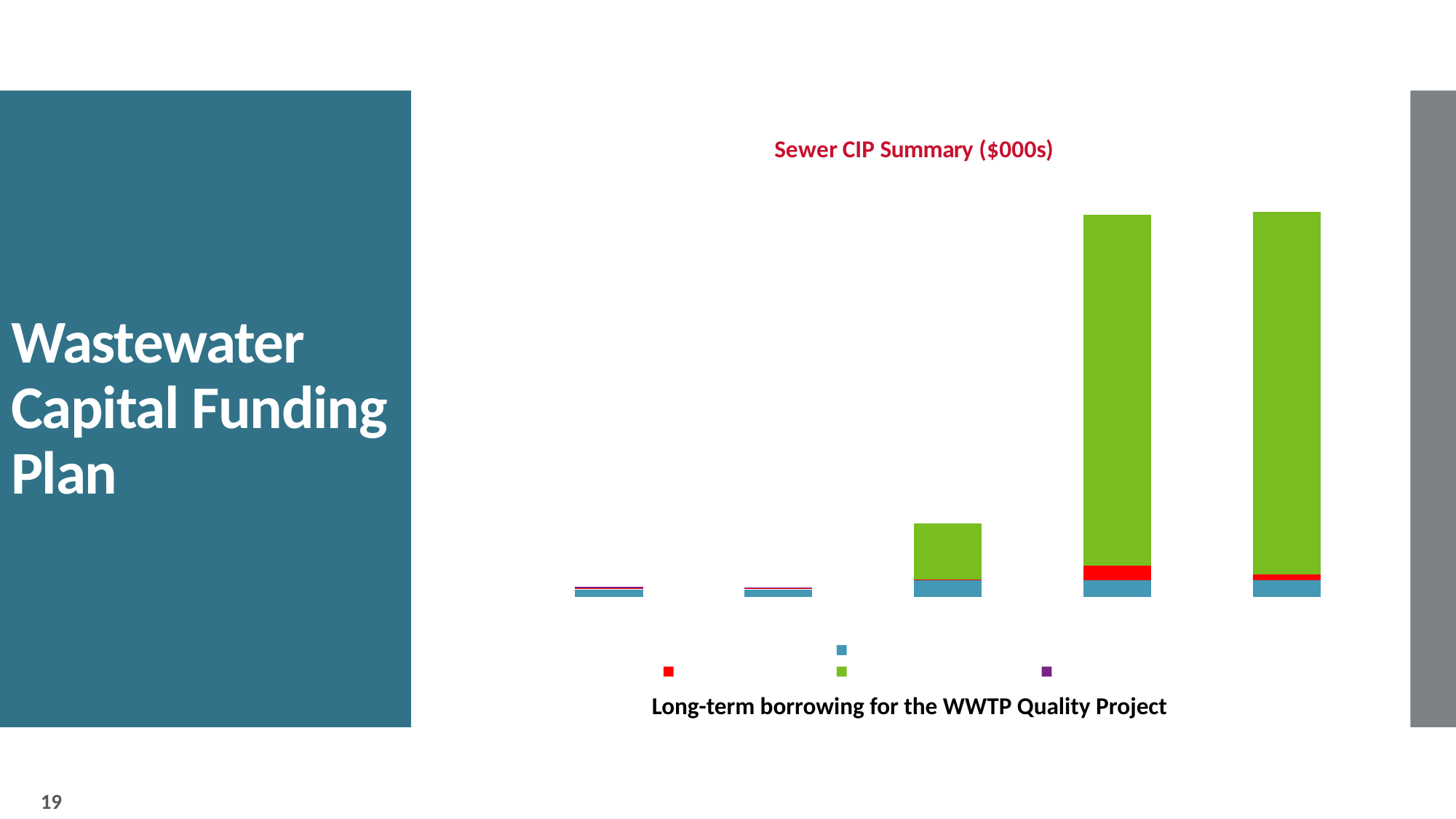
What kind of chart is shown on the slide? stacked bar chart Which is taller, the first bar from the left or the third bar from the left? the third bar Which colour segment makes up most of the two tallest bars? green Which is taller, the third bar from the left or the fourth bar from the left? the fourth bar How many series markers does the legend show? 4 Which bar is the shortest, the second bar from the left or the fifth bar from the left? the second bar What is the title of the chart? Sewer CIP Summary ($000s) Do the bar totals generally rise or fall from left to right across the chart? rise How many bars are plotted in the chart? 5